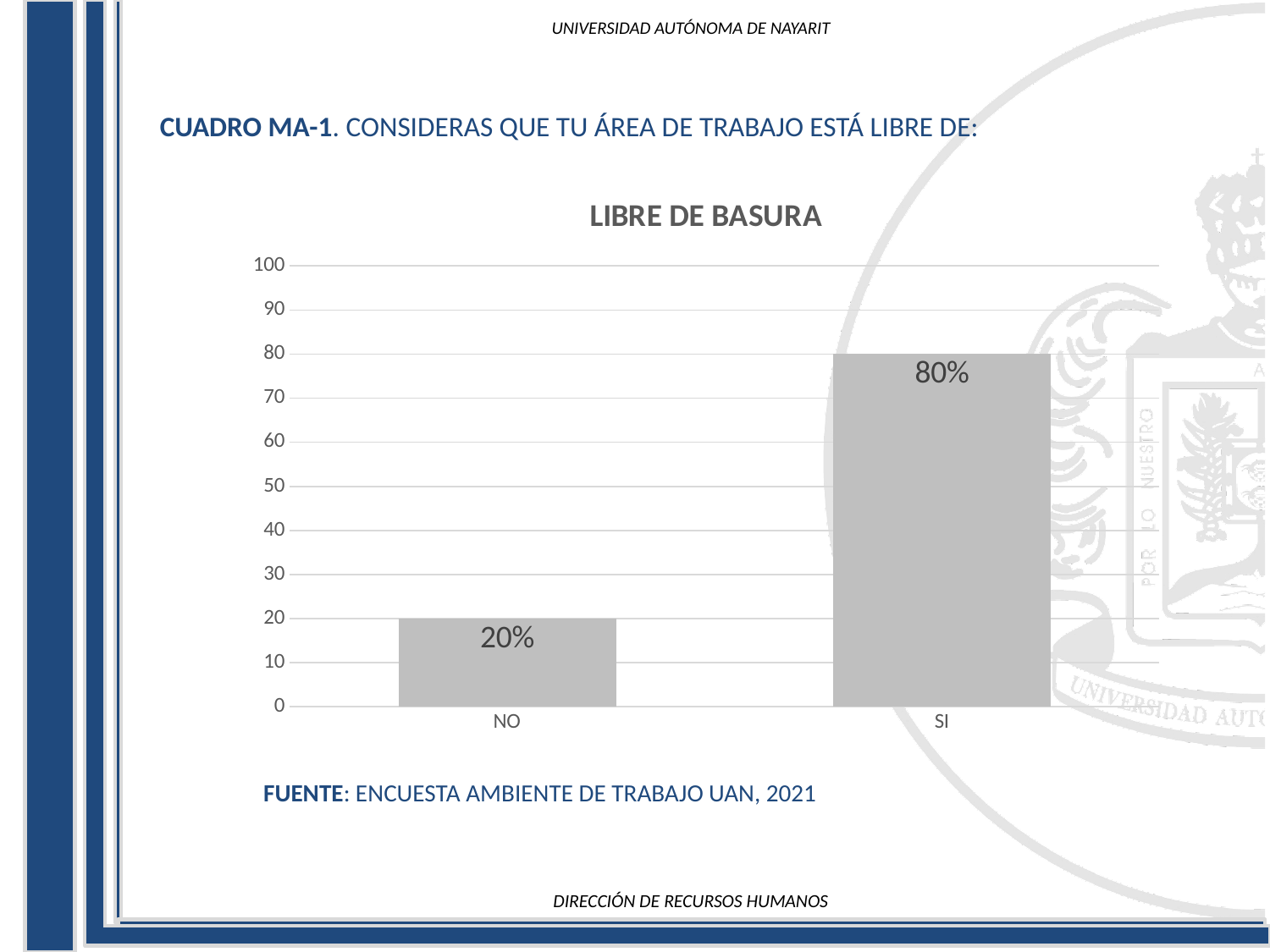
What is the difference between the values for SI and NO? 60% Is the value for NO greater or less than 30? less How many categories are shown on the x axis? 2 Which category has the highest value? SI What kind of chart is shown? bar chart What is the title of the chart? LIBRE DE BASURA Which category has the lowest value? NO What is the value for SI? 80% Is the value for SI greater or less than 50? greater What is the highest value shown on the y axis? 100 What is the value for NO? 20% Which is larger, the value for NO or the value for SI? SI